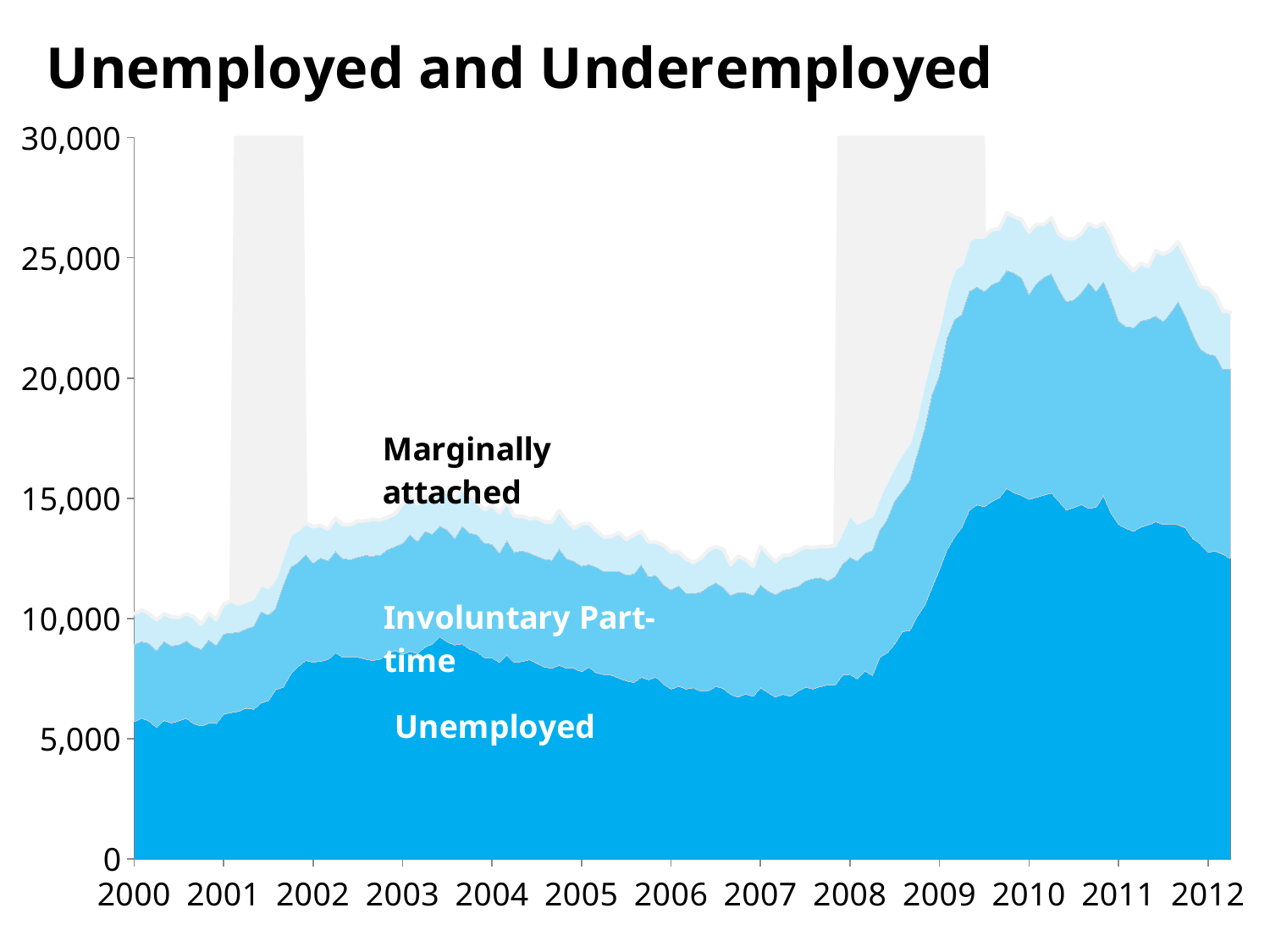
How many year labels are shown on the x axis? 13 Is the value for Unemployed at the start of 2000 greater or less than 5,000? greater How many series are labelled on the chart? 3 What is the title of the chart? Unemployed and Underemployed Which series forms the bottom (darkest blue) layer of the chart? Unemployed Does the combined total rise or fall between 2008 and 2009? rise Which series accounts for the largest share of the stacked total throughout the chart? Unemployed Does the combined total rise or fall between 2010 and 2012? fall Is the combined total of all three series at 2012 greater or less than 20,000? greater What kind of chart is shown on the slide? Stacked area chart Is the combined total of all three series at 2010 greater or less than 25,000? greater